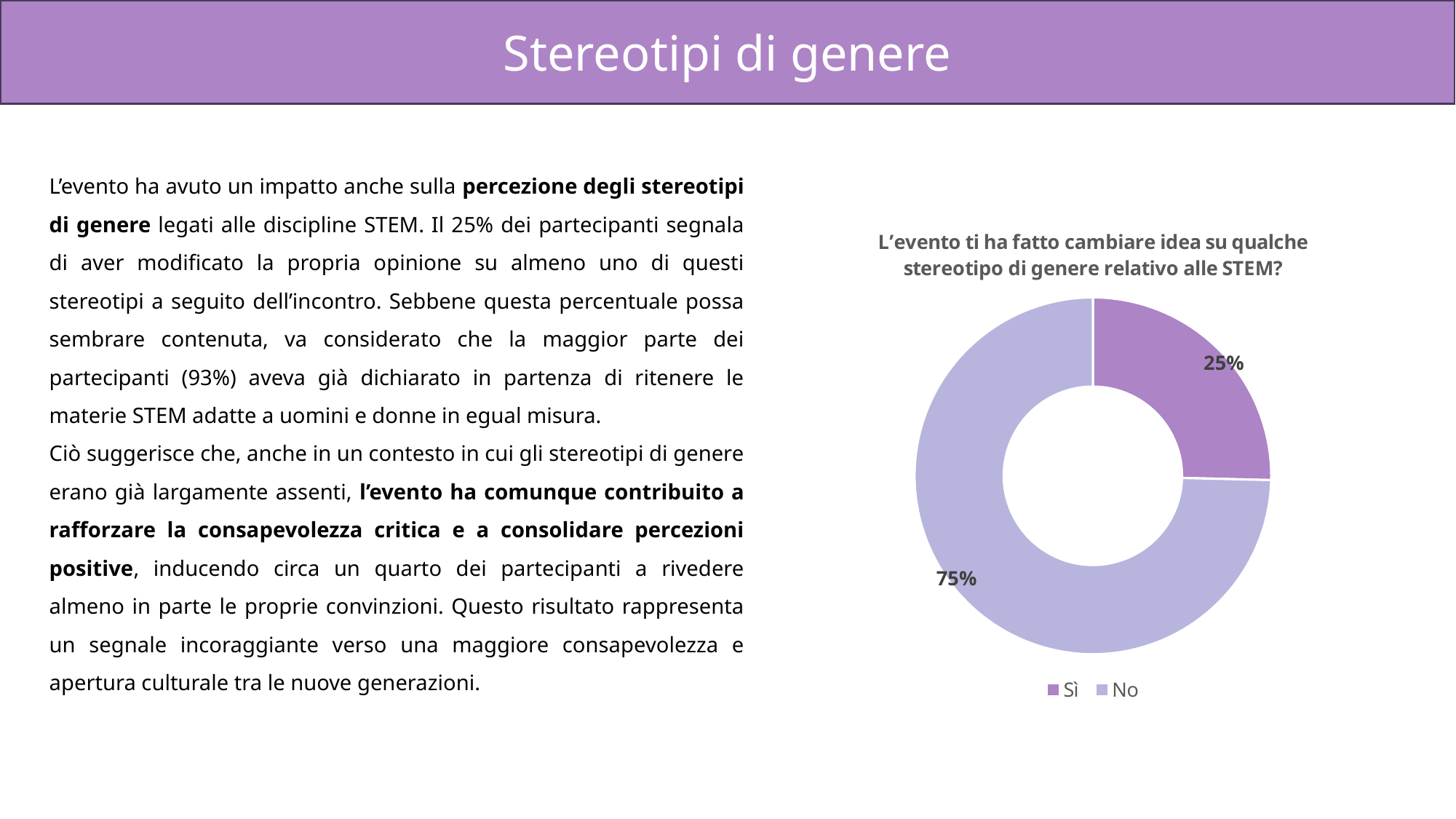
Which legend entry is shown in the darker purple colour? Sì Which response has the largest share of the chart? No Which response has the smallest share of the chart? Sì Which is larger, the share for "Sì" or the share for "No"? No What share of the chart does the "Sì" slice represent? 25% What percentage of respondents answered "No"? 75% What is the difference in percentage points between the "No" and "Sì" shares? 50 How many categories does the chart show? 2 How many entries does the legend list? 2 What is the title of the chart? L'evento ti ha fatto cambiare idea su qualche stereotipo di genere relativo alle STEM? What kind of chart is shown on the slide? Doughnut (pie) chart What percentage of respondents answered "Sì"? 25%